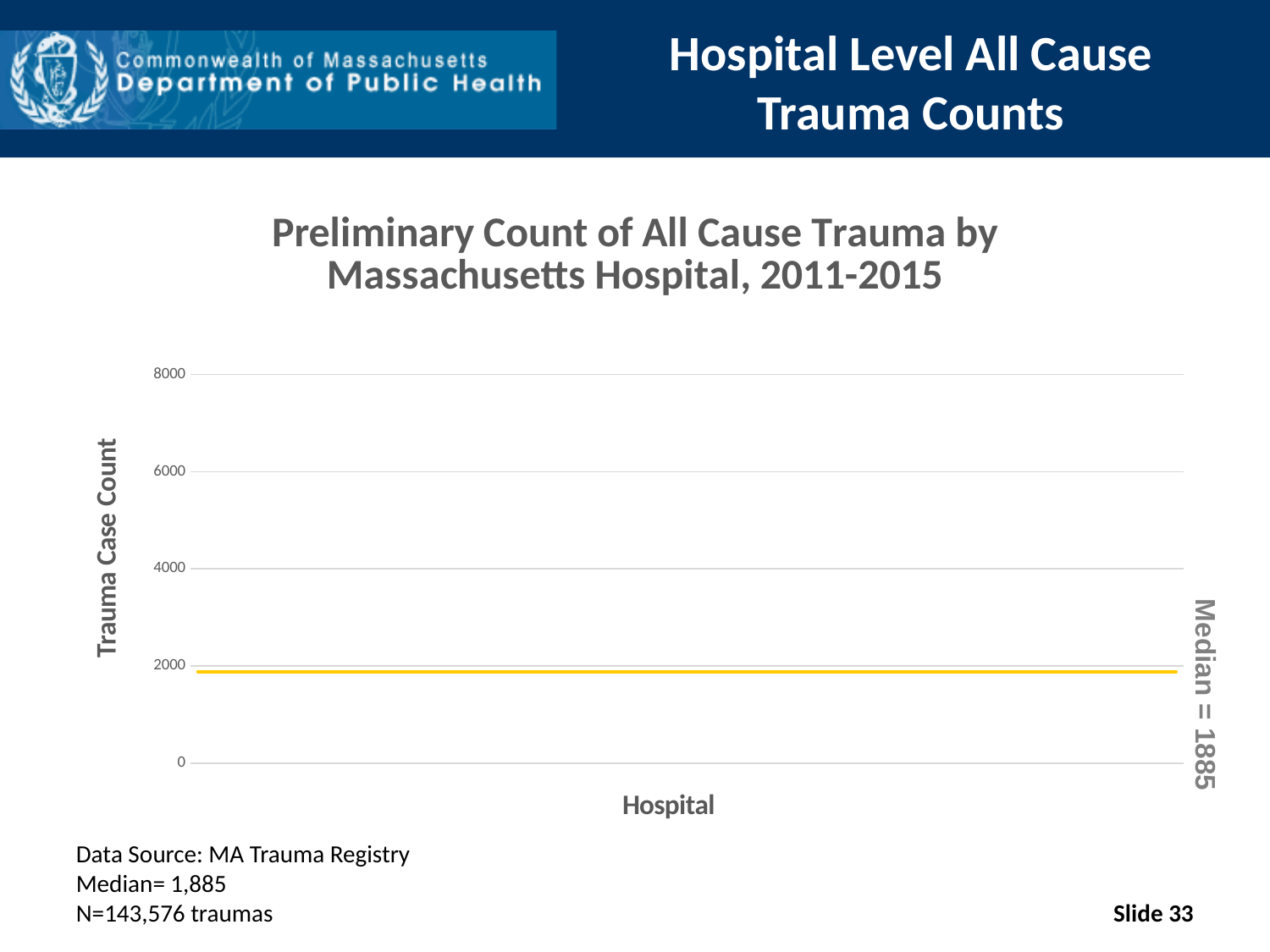
Is the median line on the chart greater or less than 1000? greater Does the yellow median line rise, fall, or stay flat across the x axis? stays flat What is the label on the vertical axis of the chart? Trauma Case Count Is the median line on the chart greater or less than 2000? less What is the highest value shown on the vertical axis of the chart? 8000 What is the title of the chart? Preliminary Count of All Cause Trauma by Massachusetts Hospital, 2011-2015 What median value is labelled on the chart? 1885